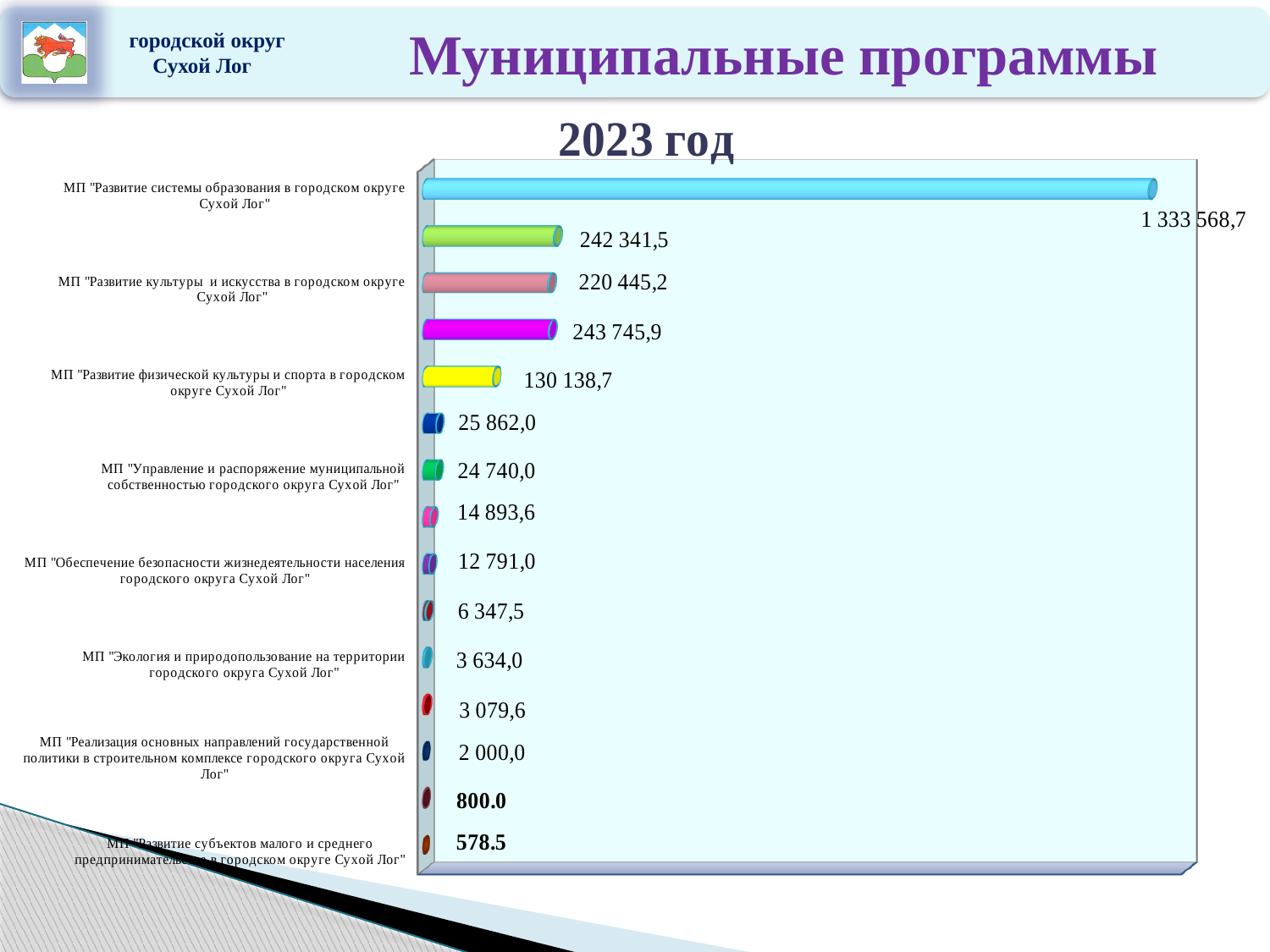
What kind of chart is shown on the slide? bar chart What is the smallest value shown in the chart? 578.5 Which programme has the highest value in the chart? МП "Развитие системы образования в городском округе Сухой Лог" What is the value for МП "Развитие системы образования в городском округе Сухой Лог"? 1 333 568,7 What is the value for МП "Развитие субъектов малого и среднего предпринимательства в городском округе Сухой Лог"? 578.5 How many bars are plotted in the chart? 15 What is the title shown above the chart? 2023 год What is the value for МП "Развитие физической культуры и спорта в городском округе Сухой Лог"? 130 138,7 What is the largest value shown in the chart? 1 333 568,7 What is the value for МП "Развитие культуры и искусства в городском округе Сухой Лог"? 220 445,2 Which is larger: the value for МП "Развитие культуры и искусства" or for МП "Развитие физической культуры и спорта"? МП "Развитие культуры и искусства" What is the difference between the value for МП "Развитие системы образования" (1 333 568,7) and МП "Развитие культуры и искусства" (220 445,2)? 1 113 123,5